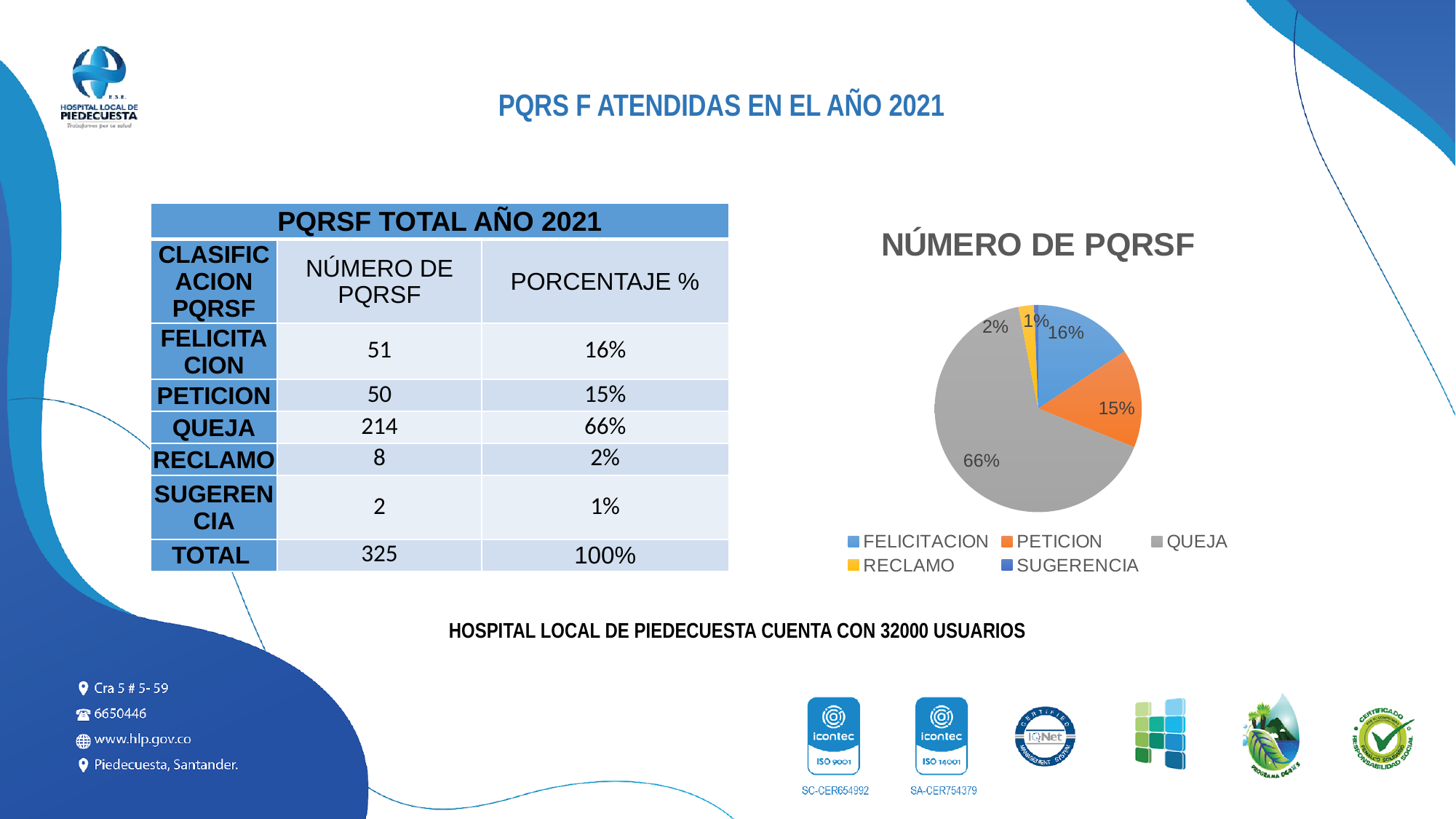
What share of the pie does PETICION represent? 15% What is the difference in percentage points between the QUEJA slice and the FELICITACION slice? 50 What kind of chart is shown on the slide? pie chart What share of the pie does RECLAMO represent? 2% How many categories does the pie chart's legend list? 5 Which category has the largest slice of the pie? QUEJA What is the title of the pie chart? NÚMERO DE PQRSF Which colour is used for the QUEJA slice in the pie chart? grey What share of the pie does QUEJA represent? 66% Which category has the smallest slice of the pie? SUGERENCIA